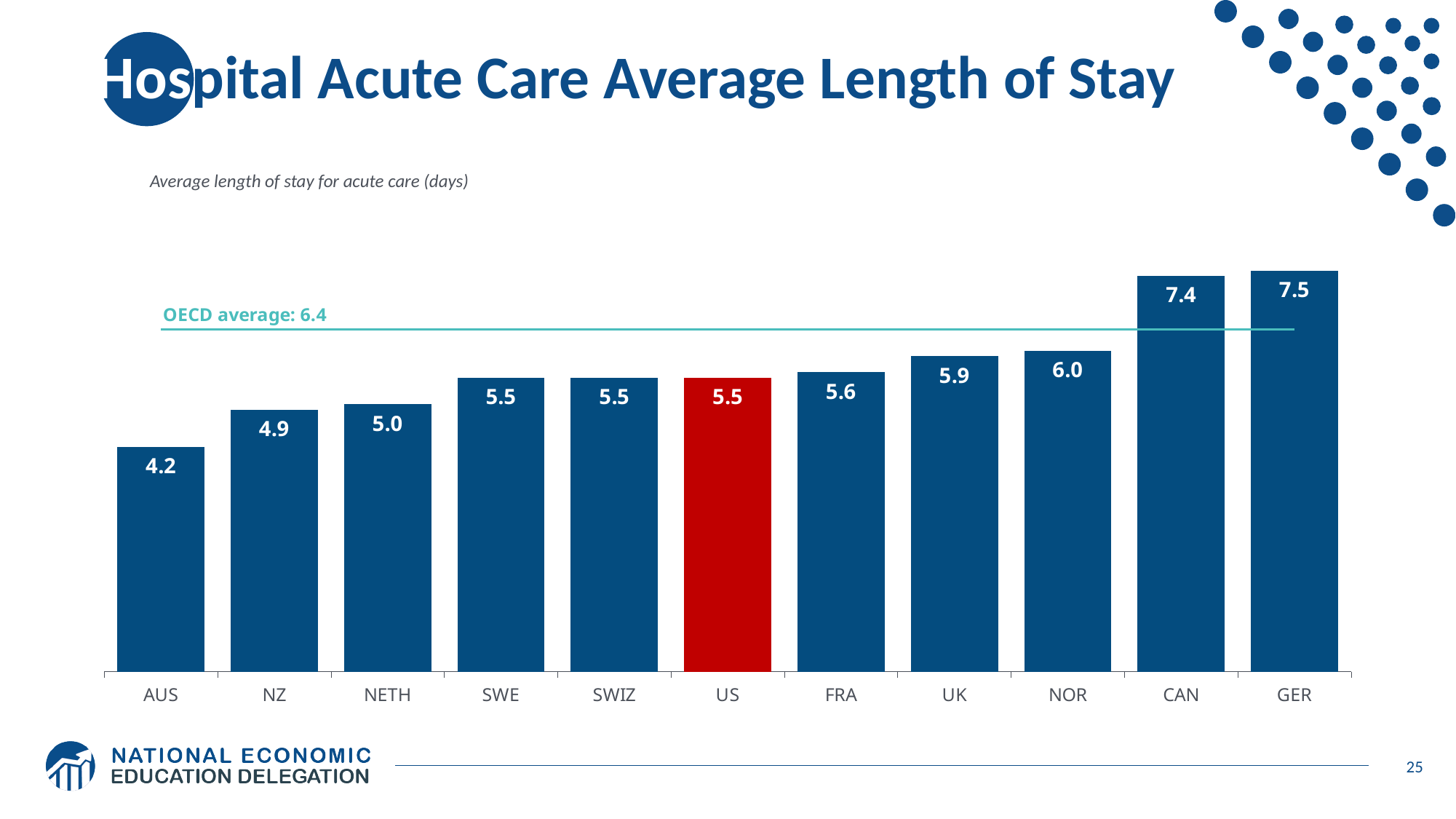
Which country has the lowest average length of stay for acute care? AUS What is the difference in average length of stay between GER and AUS? 3.3 What is the difference in average length of stay between NOR and NZ? 1.1 How many countries are shown in the chart? 11 What is the average length of stay for acute care in the US? 5.5 What kind of chart is shown on the slide? Bar chart What is the average length of stay for acute care in Canada (CAN)? 7.4 Which has a longer average length of stay, UK or NETH? UK What OECD average value is marked by the horizontal line on the chart? 6.4 Do the values generally rise or fall from left to right across the chart? Rise What is the average length of stay for acute care in Australia (AUS)? 4.2 Which country has the highest average length of stay for acute care? GER